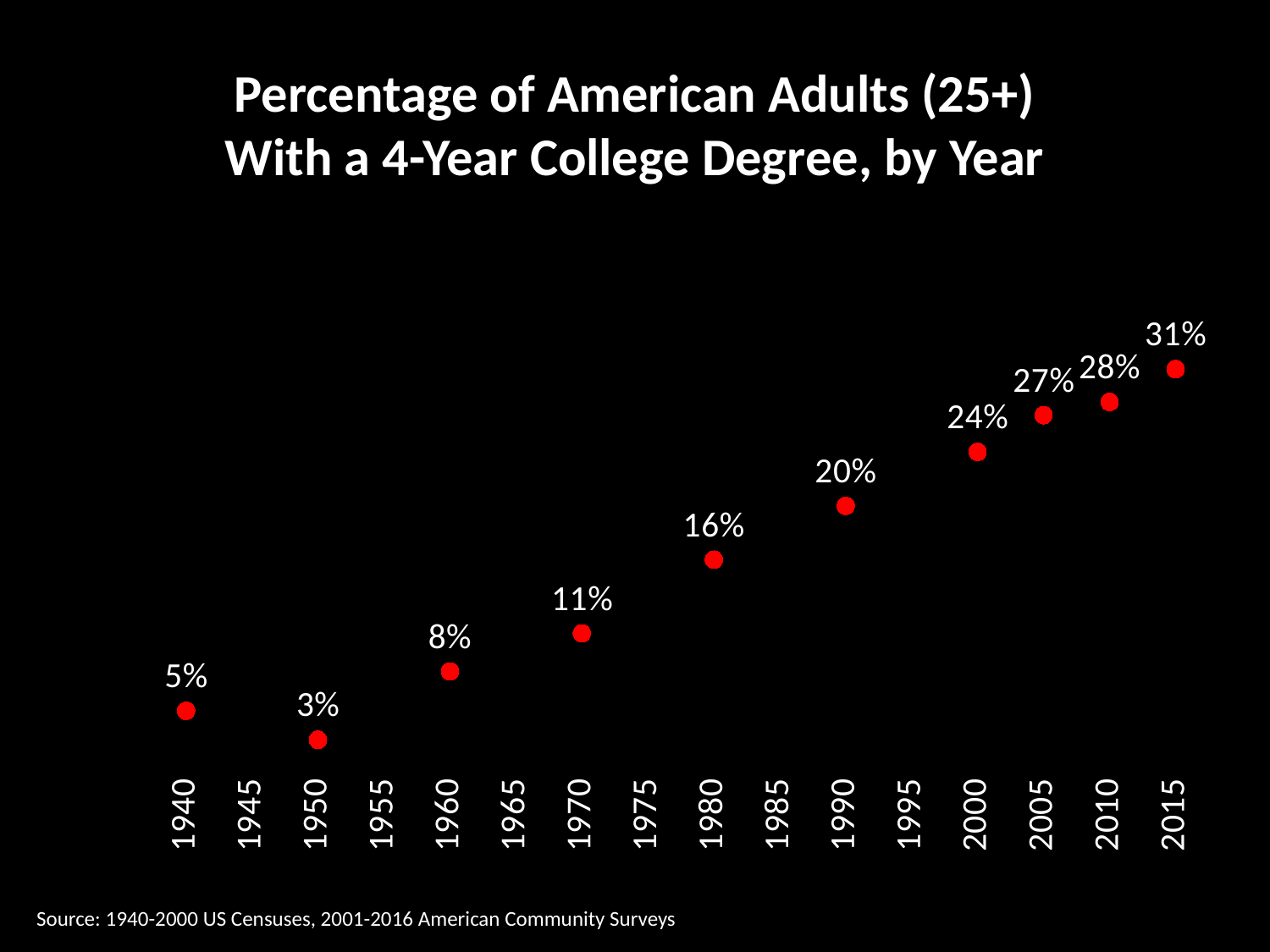
Which year has a higher value, 1960 or 1970? 1970 How many data points are plotted on the chart? 10 Do the values generally rise or fall from 1950 to 2015? Rise What is the title of the chart? Percentage of American Adults (25+) With a 4-Year College Degree, by Year What is the value shown for 1980? 16% By how many percentage points did the value increase from 1990 to 2000? 4% What percentage of American adults (25+) had a 4-year college degree in 1940? 5% What is the value shown for 2005? 27% Which year has the lowest percentage of adults with a 4-year college degree? 1950 What is the difference between the percentage in 2015 and the percentage in 1940? 26% Which year has the highest percentage of adults with a 4-year college degree? 2015 What kind of chart is shown on the slide? Scatter plot